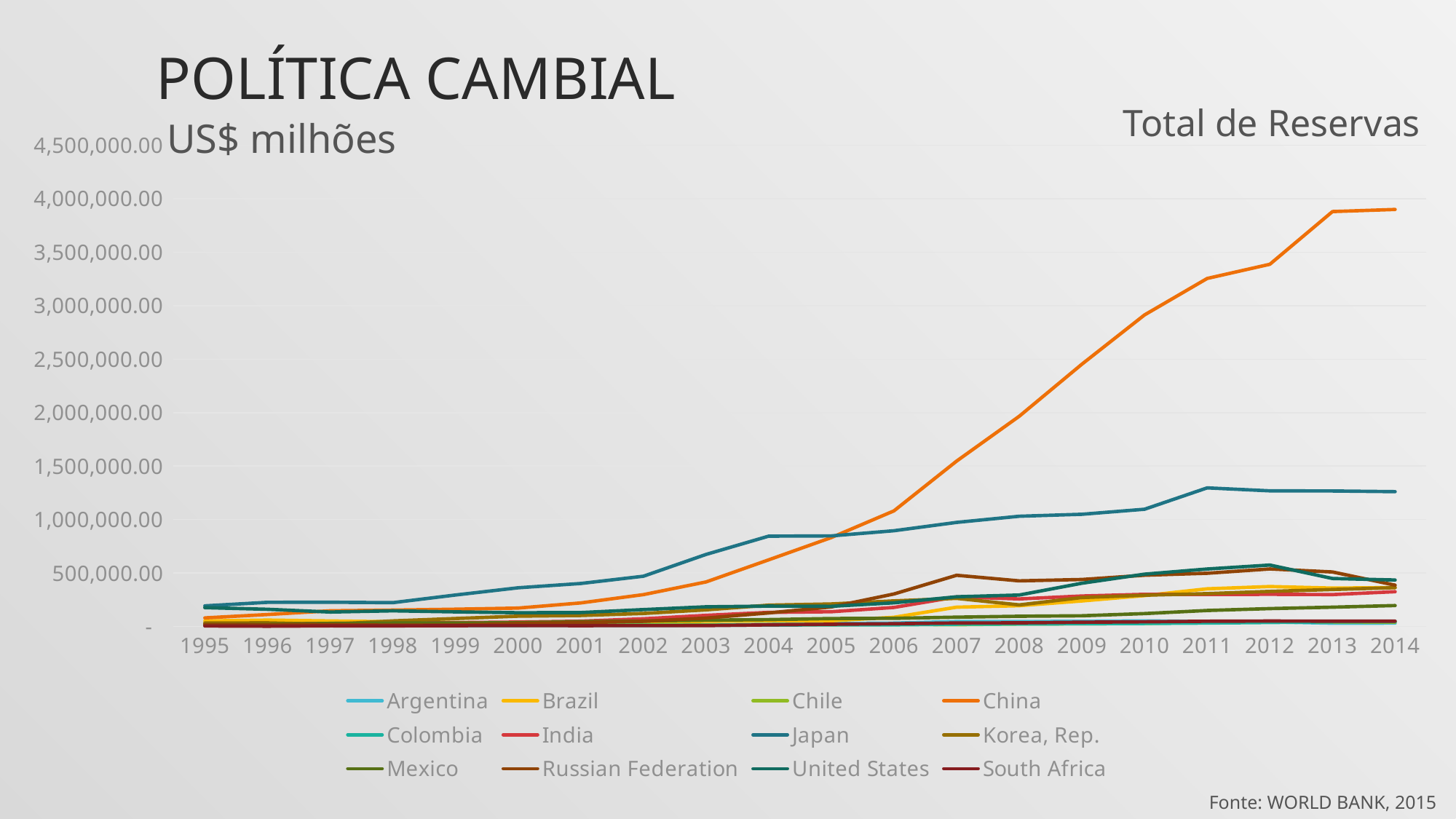
Do the values for China rise or fall from 1995 to 2014? rise How many years are shown along the x axis? 20 Which is larger in 2014, the value for China or the value for Japan? China What kind of chart is shown on the slide? line chart Is the value for China in 2004 greater or less than 500,000.00? greater Is the value for China in 2014 greater or less than 3,500,000.00? greater How many series does the legend list? 12 What is the title of the chart? Total de Reservas Which country has the highest total reserves in 2014? China What source is cited for the chart data? WORLD BANK, 2015 Is the value for Japan in 2014 greater or less than 1,000,000.00? greater